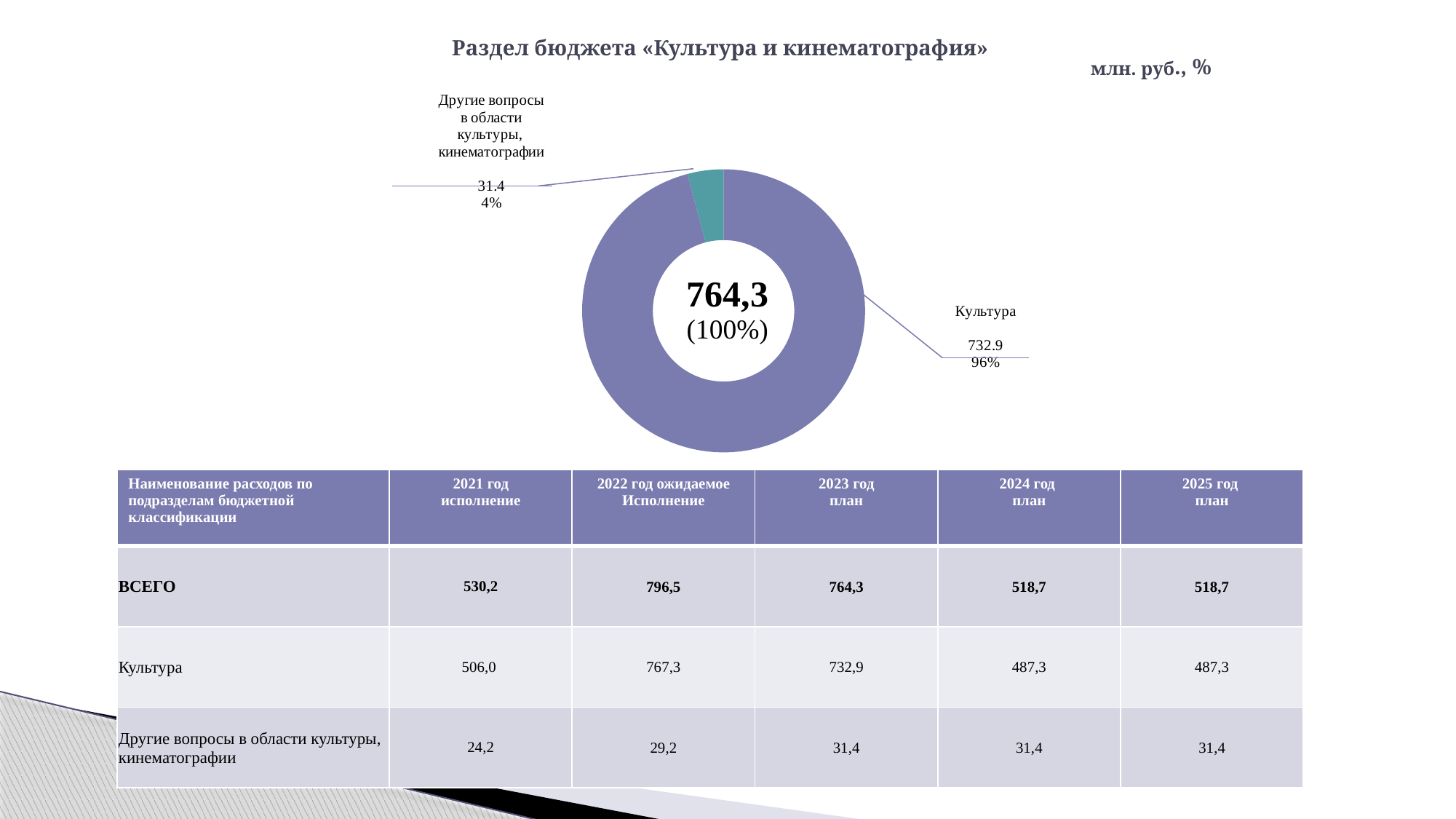
What is the value shown for the Культура slice of the donut chart? 732.9 How many slices does the donut chart have? 2 What percentage share does the Другие вопросы в области культуры, кинематографии slice have? 4% What is the value shown for the slice labelled Другие вопросы в области культуры, кинематографии? 31.4 What is the difference between the Культура value and the Другие вопросы в области культуры, кинематографии value in the donut chart? 701.5 What total value is printed in the centre of the donut chart? 764,3 What is the title of the chart on the slide? Раздел бюджета «Культура и кинематография» What percentage share does the Культура slice have in the donut chart? 96% Which slice of the donut chart is the largest? Культура Which slice of the donut chart is the smallest? Другие вопросы в области культуры, кинематографии What type of chart is shown on the slide? Pie (donut) chart Which is larger in the donut chart: Культура or Другие вопросы в области культуры, кинематографии? Культура